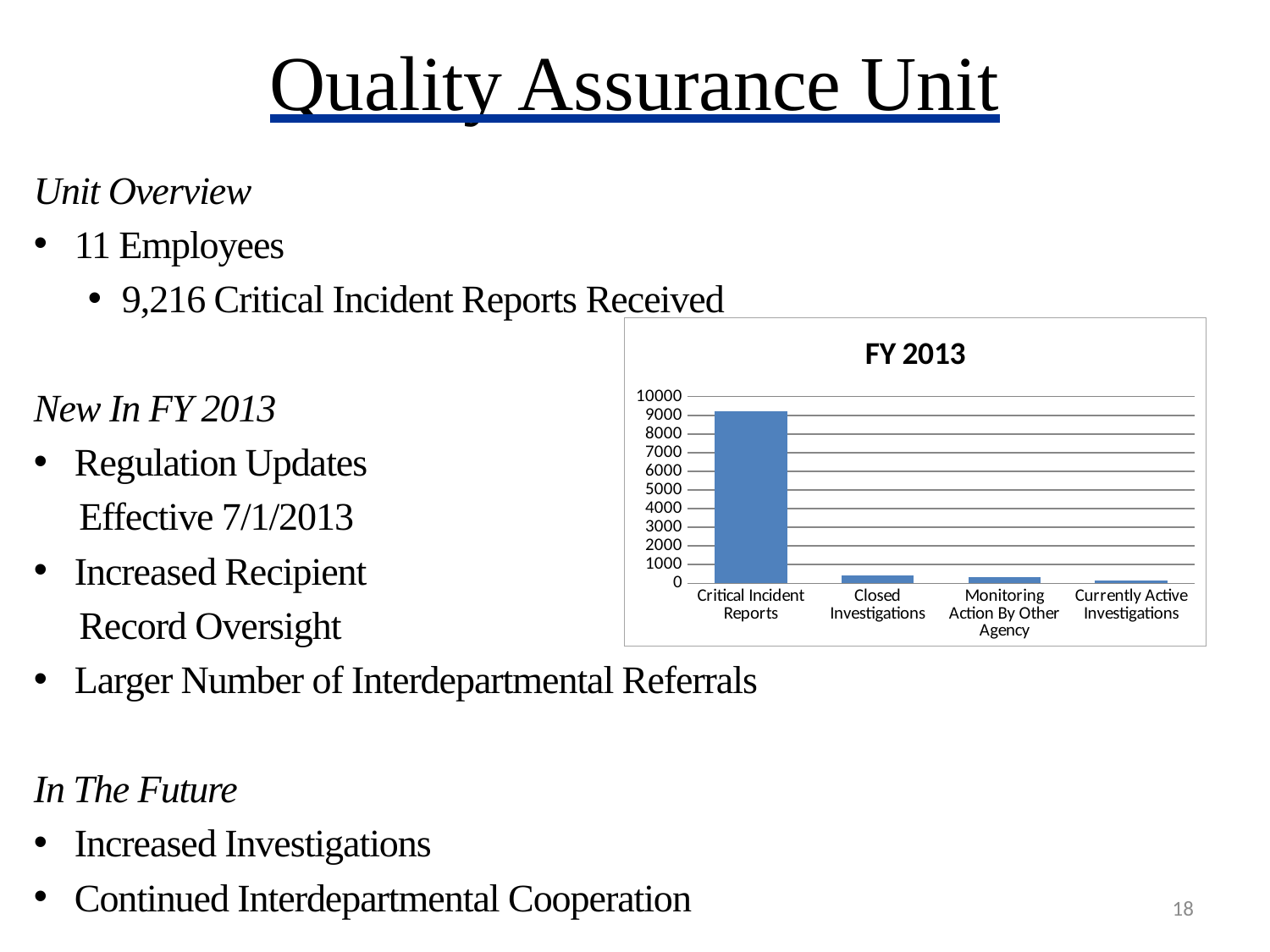
Which is larger, Closed Investigations or Currently Active Investigations? Closed Investigations What kind of chart is shown on the slide? bar chart Do the values rise or fall from left to right across the categories? fall Which category has the highest value in the chart? Critical Incident Reports Which category has the lowest value in the chart? Currently Active Investigations Is the value for Critical Incident Reports greater or less than 9000? greater How many categories are shown in the chart? 4 Which is larger, Critical Incident Reports or Closed Investigations? Critical Incident Reports Is the value for Closed Investigations greater or less than 1000? less Is the value for Currently Active Investigations greater or less than 1000? less What is the title of the chart? FY 2013